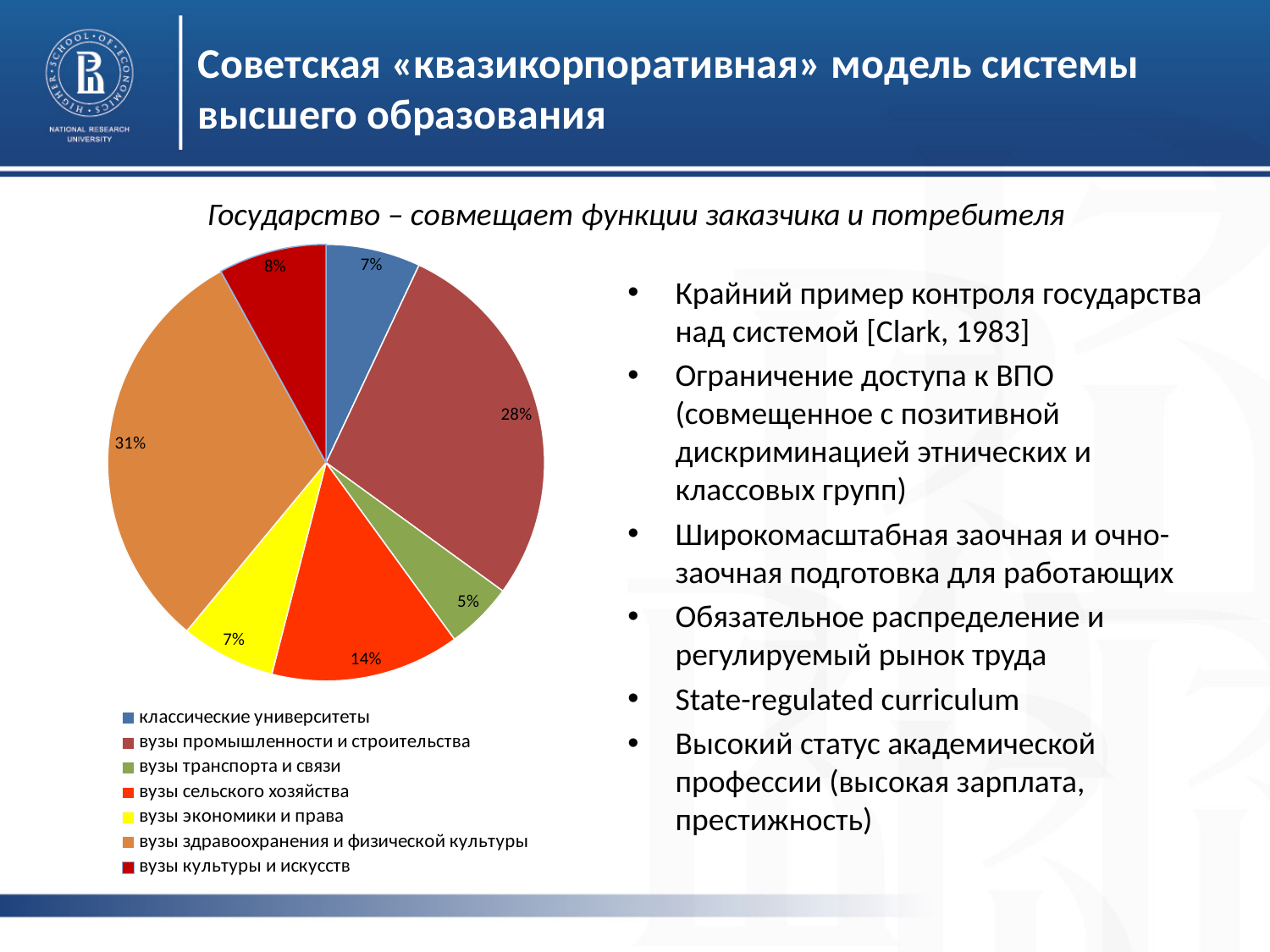
What colour is the slice for вузы экономики и права? yellow What share of the pie is labelled for вузы культуры и искусств? 8% What share of the pie is labelled for вузы промышленности и строительства? 28% What kind of chart is shown on the slide? pie chart How many slices does the pie chart have? 7 What share of the pie is labelled for вузы здравоохранения и физической культуры? 31% What share of the pie is labelled for вузы транспорта и связи? 5% What is the difference in percentage points between the slices for вузы здравоохранения и физической культуры and вузы промышленности и строительства? 3 Which category has the largest slice of the pie? вузы здравоохранения и физической культуры Which slice is larger: вузы сельского хозяйства or вузы культуры и искусств? вузы сельского хозяйства What share of the pie is labelled for вузы сельского хозяйства? 14% Which category has the smallest slice of the pie? вузы транспорта и связи